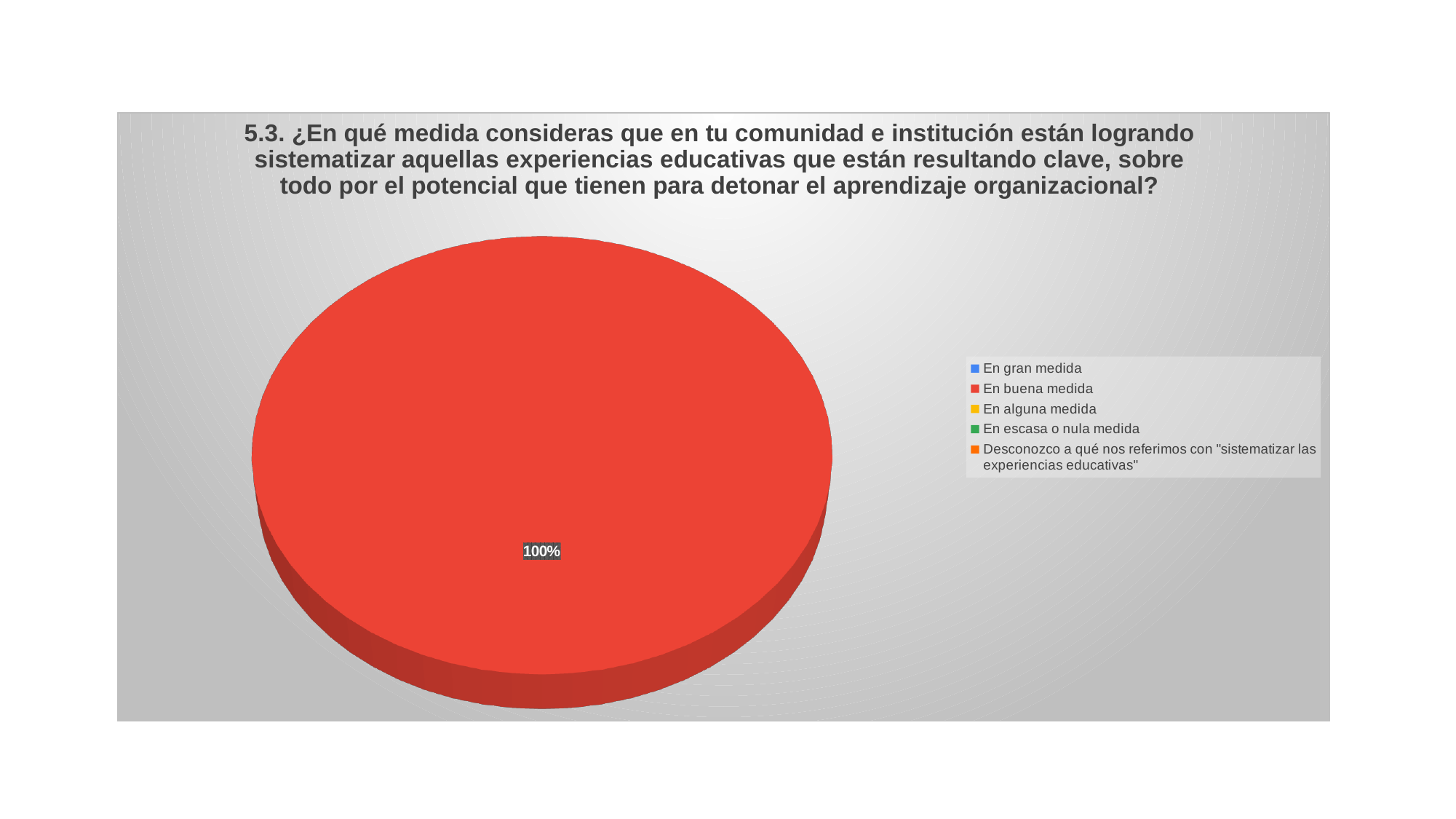
Is the value for "En buena medida" greater or less than 50%? greater Which legend entry is shown in blue? En gran medida What kind of chart is shown on the slide? pie chart What colour is the "En buena medida" slice? red What percentage is shown for the "En buena medida" slice? 100% What share of the pie does "En buena medida" represent? 100% Which category accounts for the entire pie? En buena medida How many entries does the legend list? 5 How many slices are visible in the pie? 1